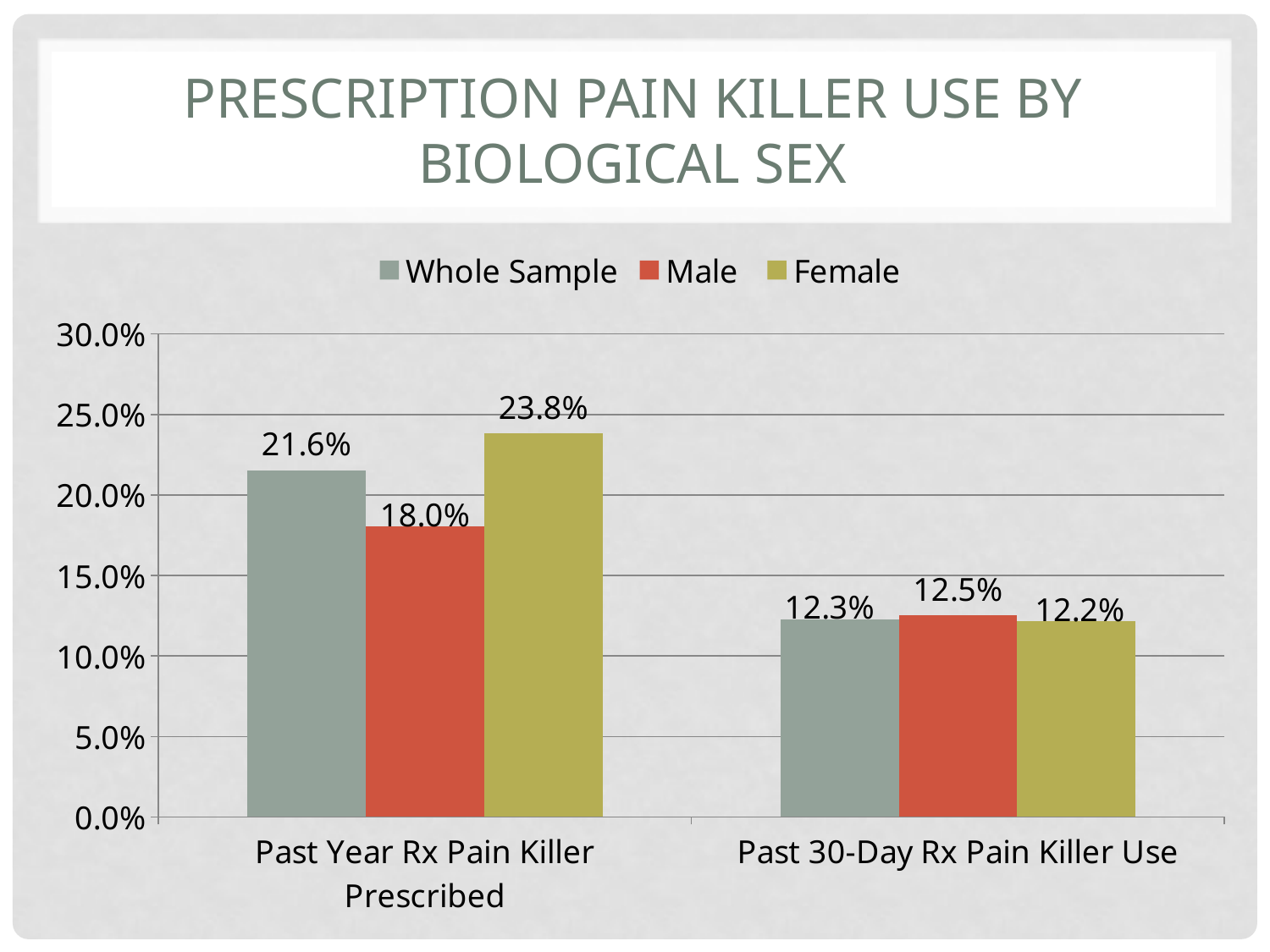
What kind of chart is shown on the slide? Bar chart What is the title of the slide? Prescription Pain Killer Use by Biological Sex What is the Whole Sample value for Past Year Rx Pain Killer Prescribed? 21.6% What is the Female value for Past Year Rx Pain Killer Prescribed? 23.8% Which series has the lowest value for Past Year Rx Pain Killer Prescribed? Male What is the difference between the Whole Sample values for Past Year Rx Pain Killer Prescribed and Past 30-Day Rx Pain Killer Use? 9.3% Which is larger: the Male value for Past Year Rx Pain Killer Prescribed or the Male value for Past 30-Day Rx Pain Killer Use? Past Year Rx Pain Killer Prescribed How many categories are shown on the x axis? 2 What is the difference between the Female and Male values for Past Year Rx Pain Killer Prescribed? 5.8% How many series does the legend list? 3 What is the Male value for Past 30-Day Rx Pain Killer Use? 12.5% Which series has the highest value for Past Year Rx Pain Killer Prescribed? Female